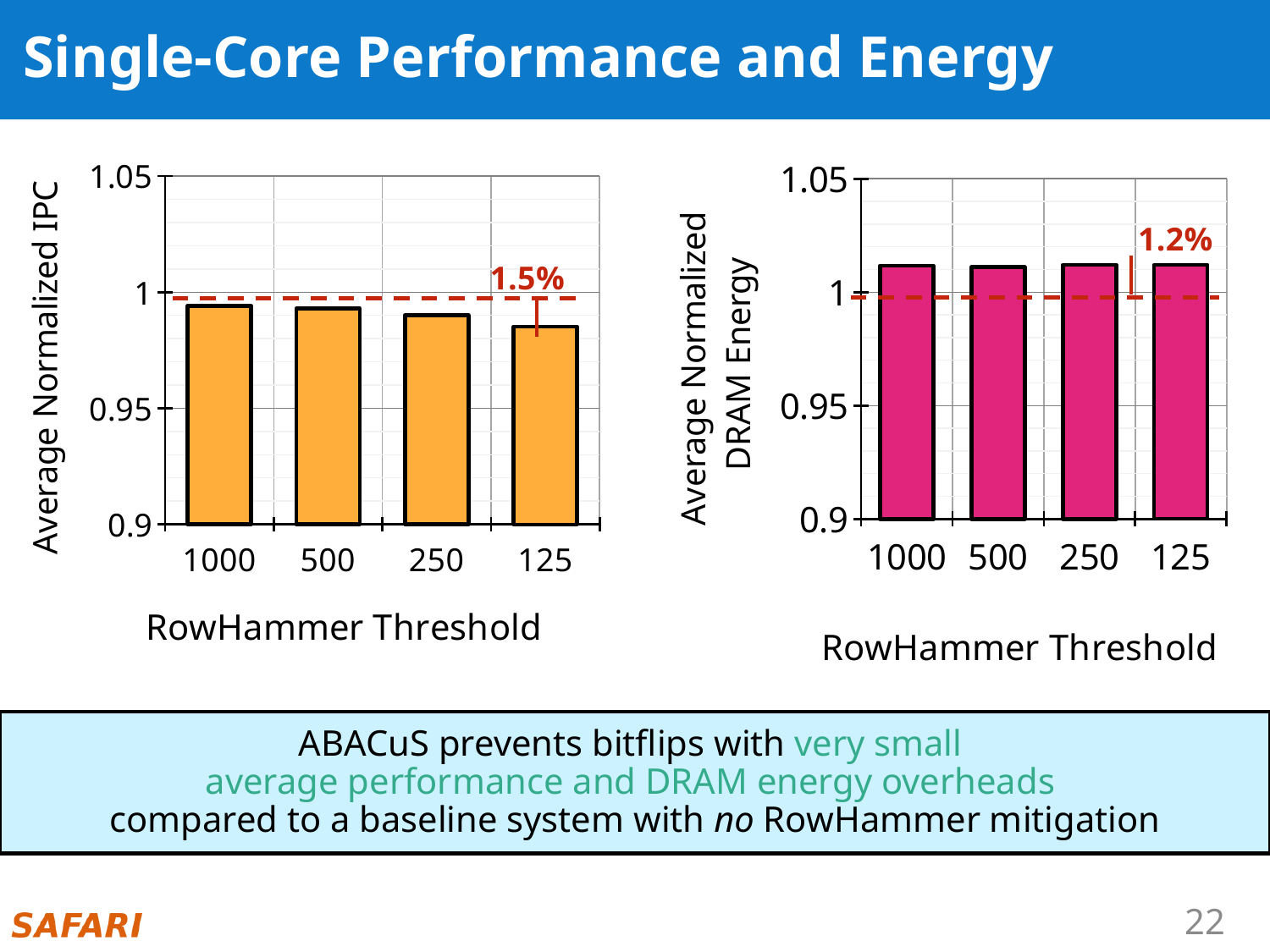
On the left chart (Average Normalized IPC), which is larger: the value for RowHammer Threshold 1000 or for 125? 1000 How many RowHammer Threshold categories are shown on the left chart (Average Normalized IPC)? 4 How many bars are plotted on the right chart (Average Normalized DRAM Energy)? 4 On the left chart (Average Normalized IPC), which RowHammer Threshold has the highest average normalized IPC? 1000 On the right chart (Average Normalized DRAM Energy), is the value for RowHammer Threshold 1000 greater or less than 1? greater On the left chart (Average Normalized IPC), do the bar values rise or fall as the RowHammer Threshold goes from 1000 to 125 along the x axis? fall What percentage overhead is annotated on the right chart (Average Normalized DRAM Energy)? 1.2% On the left chart (Average Normalized IPC), which RowHammer Threshold has the lowest average normalized IPC? 125 What kind of chart is the left chart (Average Normalized IPC)? bar chart On the left chart (Average Normalized IPC), is the value for RowHammer Threshold 1000 greater or less than 0.95? greater On the left chart (Average Normalized IPC), is the value for RowHammer Threshold 125 greater or less than 1? less What percentage overhead is annotated on the left chart (Average Normalized IPC)? 1.5%